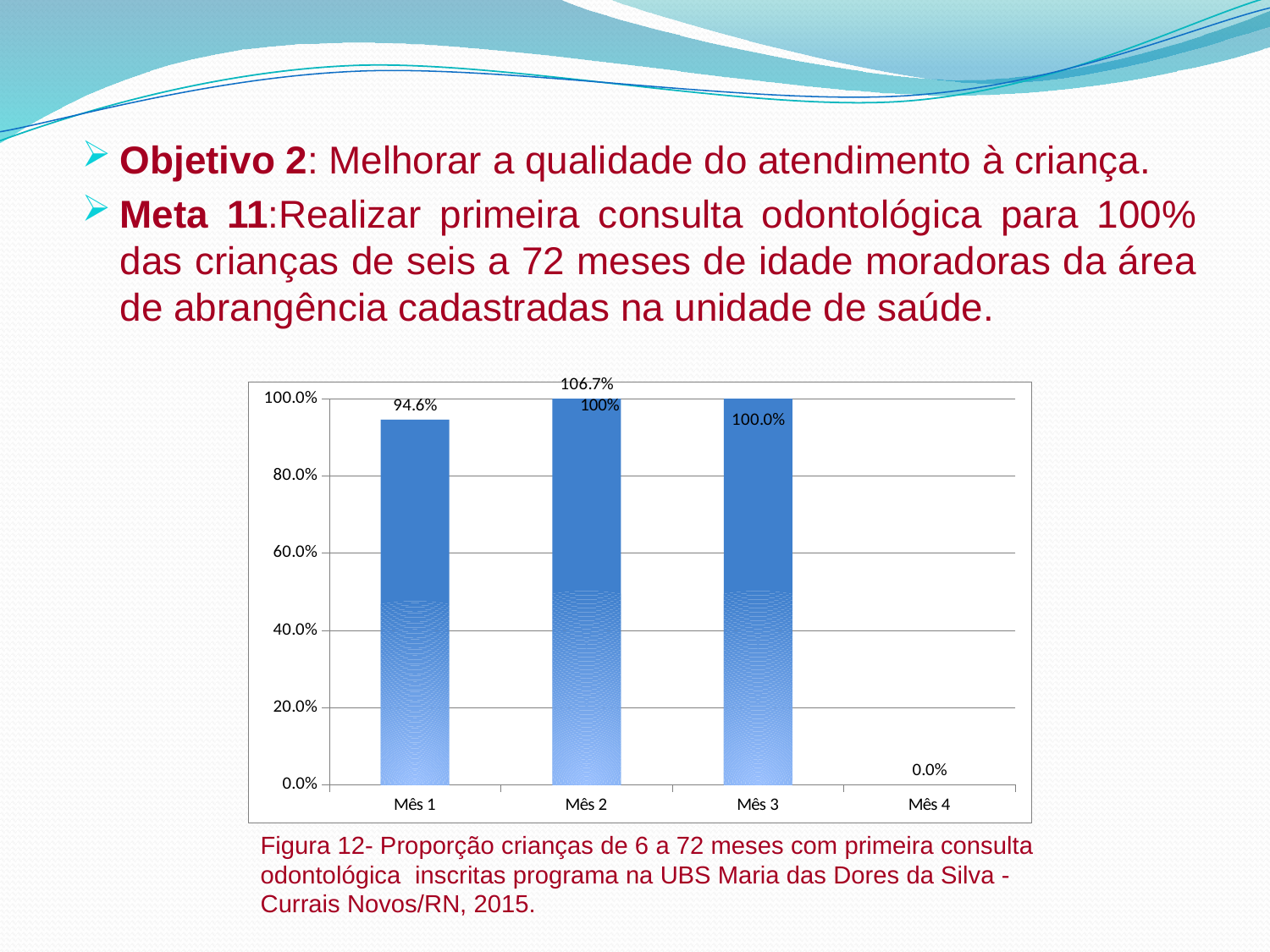
What is the value for Mês 4? 0.0% Which month has the lowest value? Mês 4 What is the difference between the values for Mês 3 and Mês 1? 5.4% What is the value for Mês 3? 100.0% Which is larger, the value for Mês 1 or the value for Mês 3? Mês 3 Is the value for Mês 1 greater or less than 80.0%? greater Does the value rise or fall from Mês 3 to Mês 4? fall What is the value for Mês 1? 94.6% What kind of chart is shown on the slide? bar chart What figure number is given in the caption below the chart? Figura 12 Which is larger, the value for Mês 1 or the value for Mês 4? Mês 1 How many months are shown on the x axis? 4